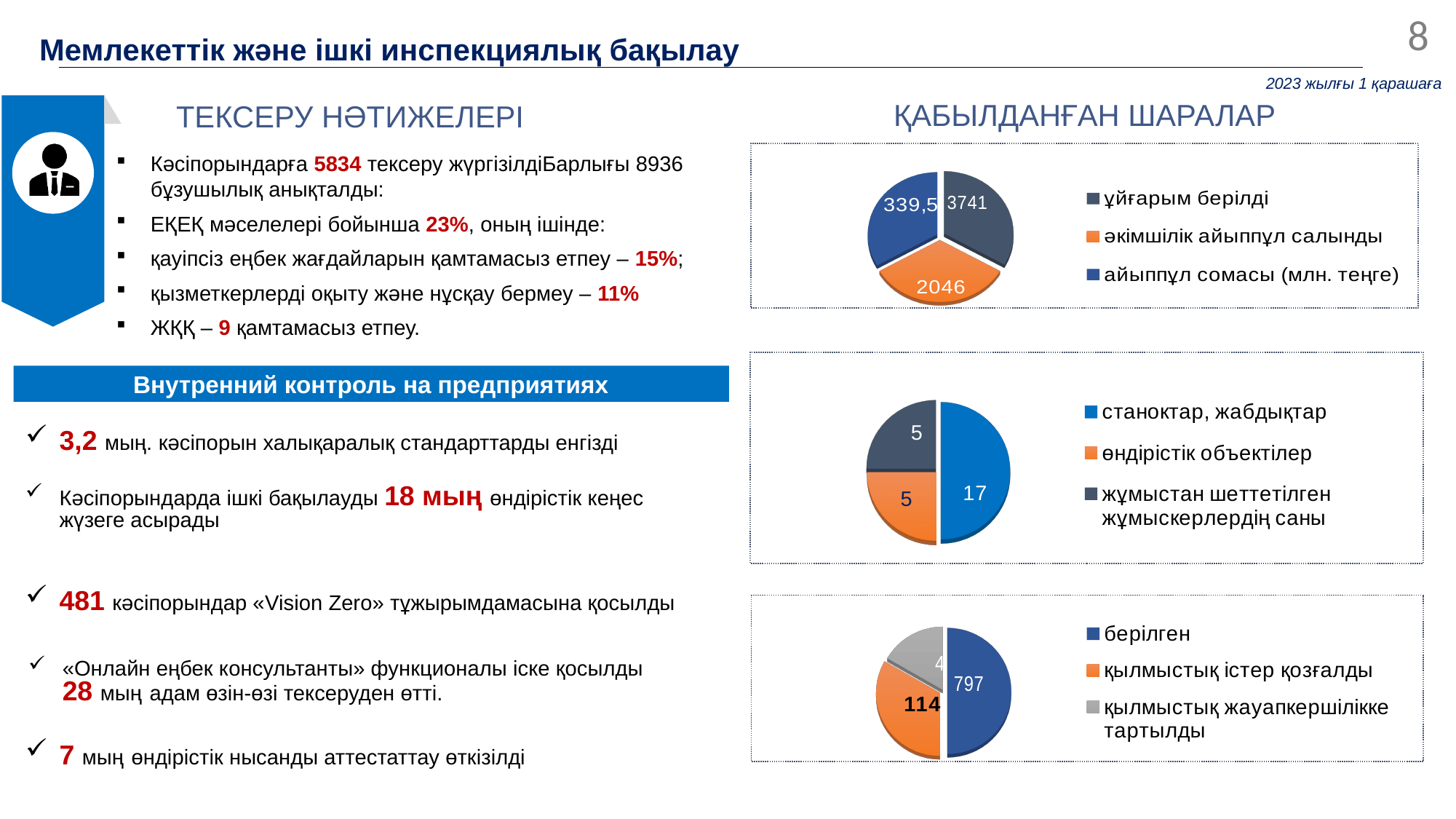
In the top pie chart on the right, what is the value for айыппұл сомасы (млн. теңге)? 339,5 In the bottom pie chart on the right, what is the value for қылмыстық істер қозғалды? 114 How many legend entries does the middle pie chart on the right list? 3 In the bottom pie chart on the right, which category has the smallest value? қылмыстық жауапкершілікке тартылды In the bottom pie chart on the right, what is the value for берілген? 797 In the top pie chart on the right, what is the value for ұйғарым берілді? 3741 What type of chart is the bottom chart on the right? Pie chart In the top pie chart on the right, what is the difference between ұйғарым берілді and әкімшілік айыппұл салынды? 1695 In the middle pie chart on the right, what is the value for станоктар, жабдықтар? 17 In the middle pie chart on the right, what is the value for өндірістік объектілер? 5 In the top pie chart on the right, which category has the largest value? ұйғарым берілді In the top pie chart on the right, what is the value for әкімшілік айыппұл салынды? 2046